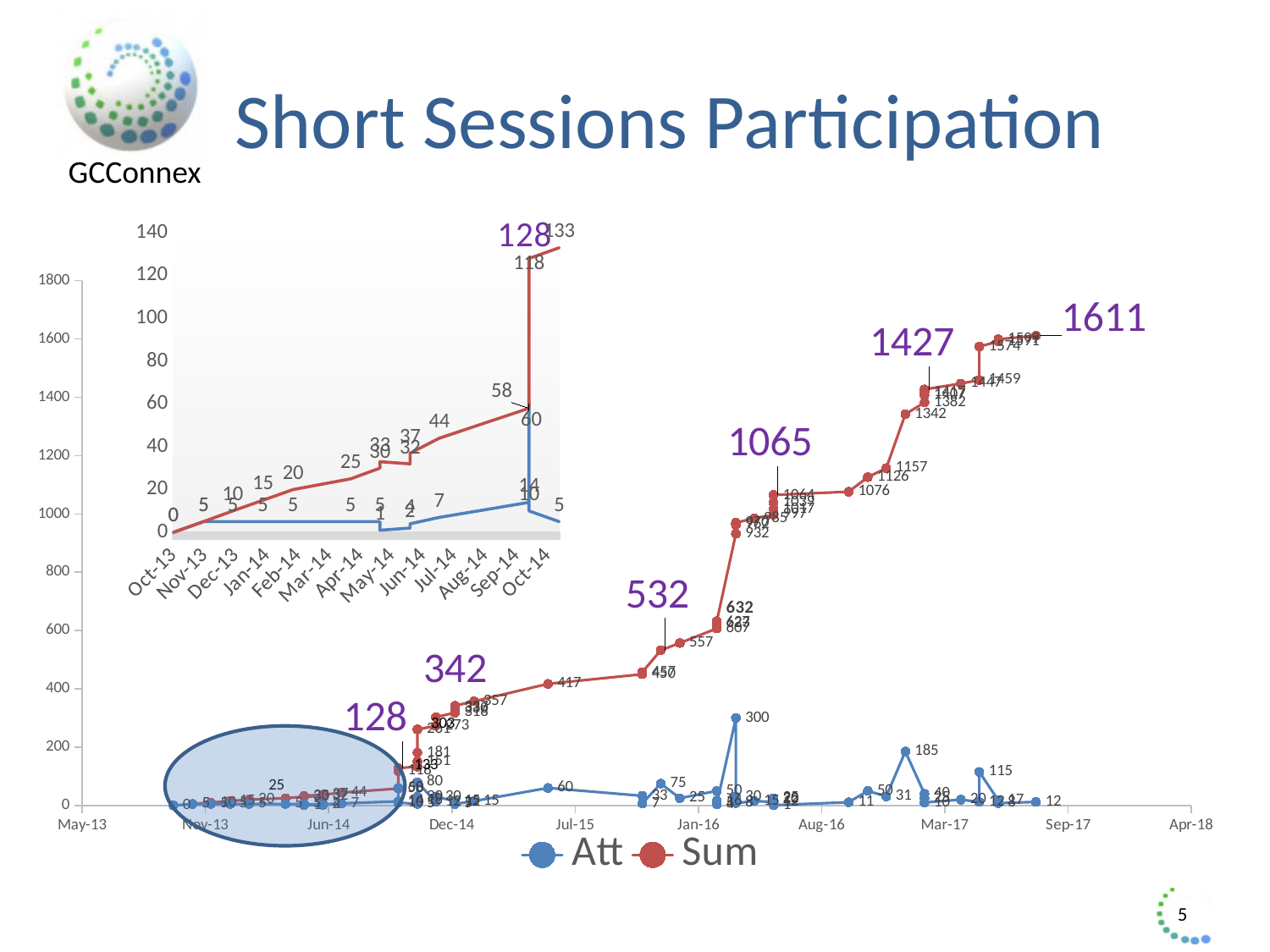
On the inset chart, what is the first label on the x axis? Oct-13 On the main chart, does the Sum series rise or fall from left to right? Rises On the main chart, which series reaches higher values, Att or Sum? Sum On the inset chart, what is the last labeled value of the red line? 133 On the main chart, is the Sum value at Jan-16 greater or less than 400? greater On the main chart, what is the difference between the annotated values 1611 and 1427? 184 On the main chart, what are the names of the two series in the legend? Att and Sum On the main chart, how many series does the legend list? 2 On the main chart, what is the highest annotated value of the Sum series? 1611 What kind of chart is the main chart on the slide? Line chart On the main chart, what is the highest labeled value of the Att series? 300 On the inset chart, what is the highest labeled value of the blue line? 60